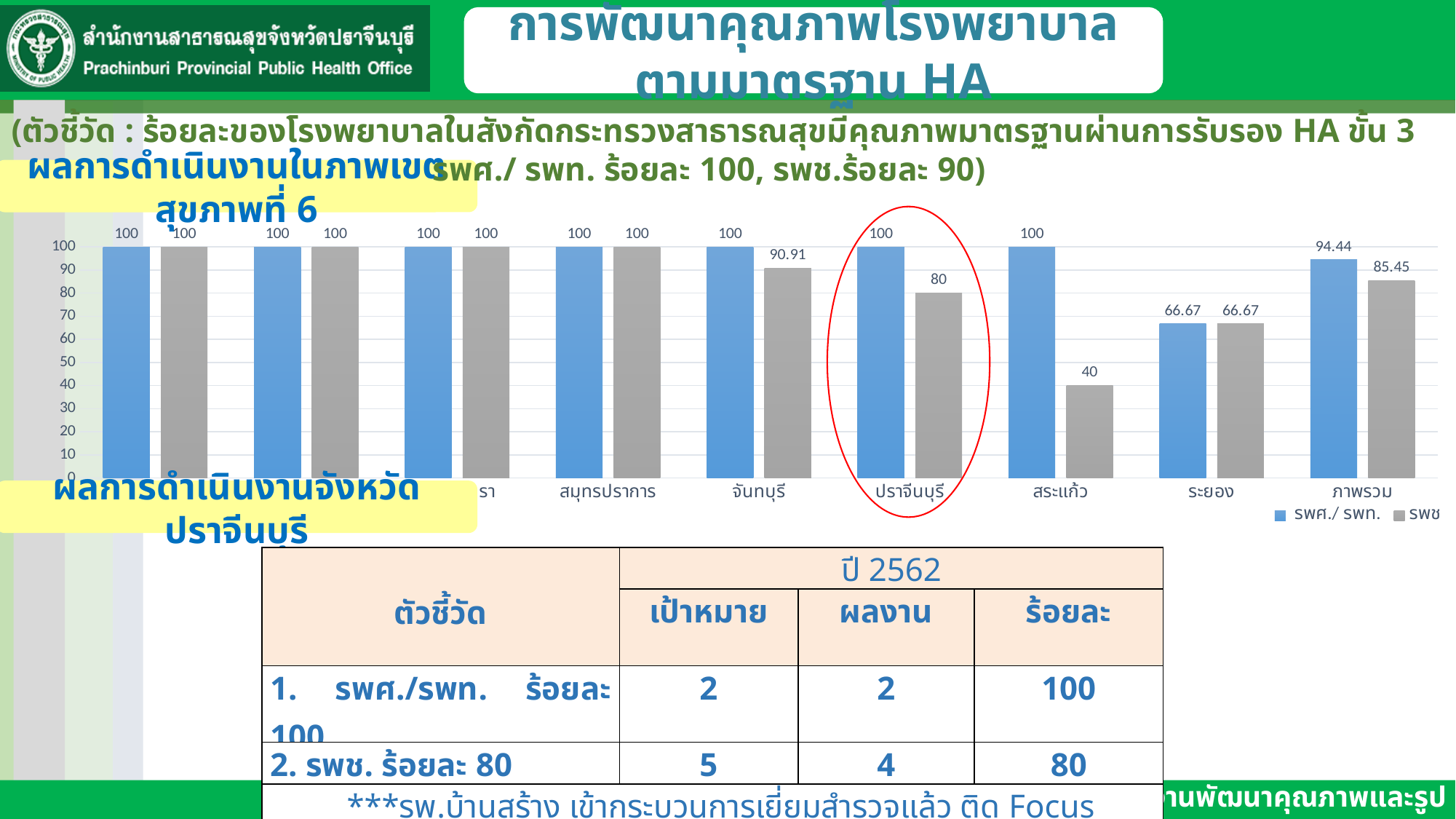
What is the value for รพช in ภาพรวม? 85.45 What is the value for รพศ./ รพท. in ภาพรวม? 94.44 What is the difference between the รพศ./ รพท. value and the รพช value in สระแก้ว? 60 What is the value for รพช in ปราจีนบุรี? 80 Which category has the lowest รพช value? สระแก้ว How many series does the chart legend list? 2 Which is larger in ภาพรวม, the รพศ./ รพท. value or the รพช value? รพศ./ รพท. Which category on the chart is circled in red? ปราจีนบุรี What is the value for รพช in จันทบุรี? 90.91 Which category has the lowest รพศ./ รพท. value? ระยอง How many categories (groups of bars) are plotted in the chart? 9 What type of chart is shown on the slide? bar chart